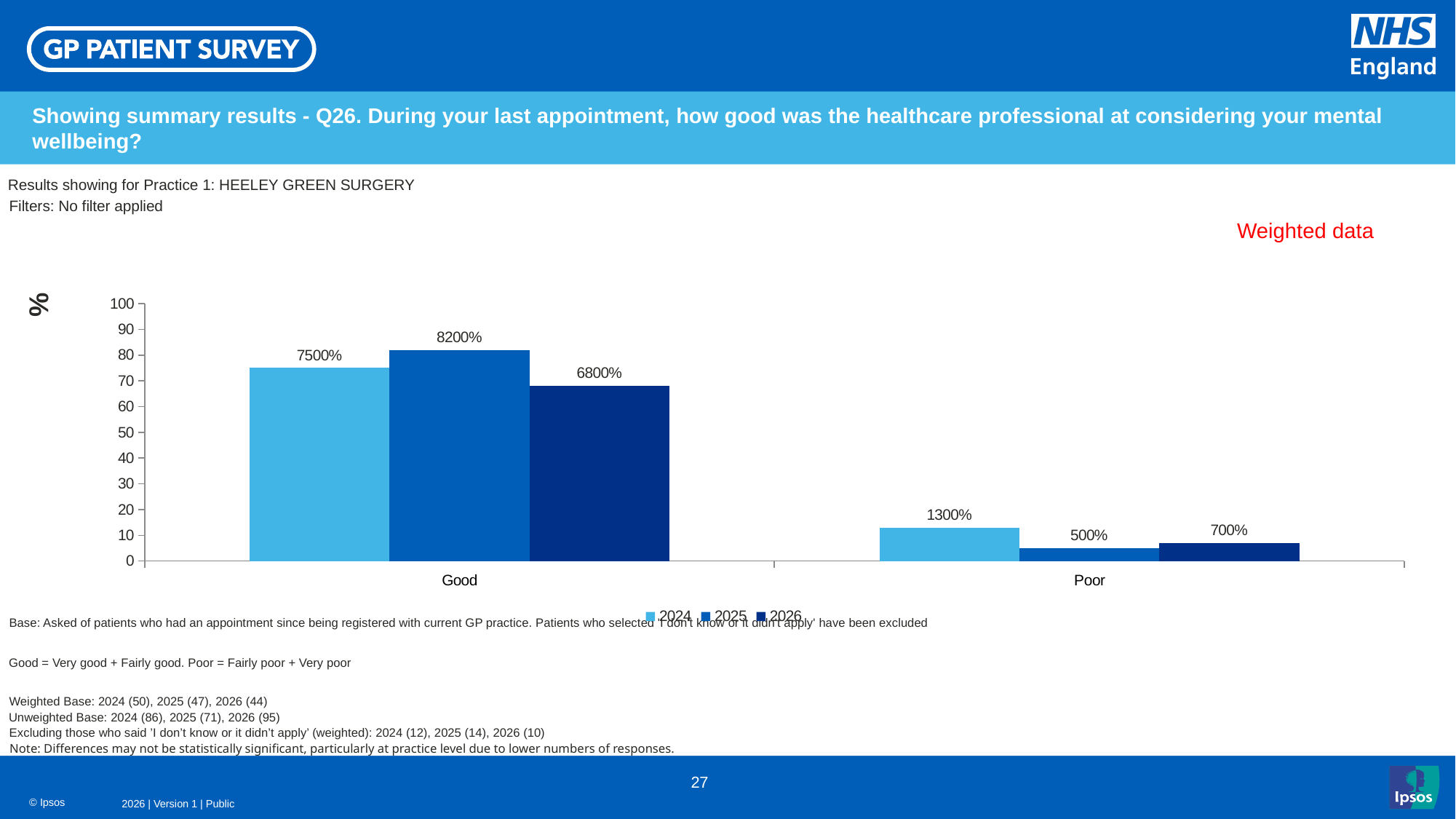
Which year has the highest bar in the Good category? 2025 How many categories are shown on the x axis? 2 How many series does the legend list? 3 Which year has the lowest bar in the Poor category? 2025 What kind of chart is shown on the slide? Bar chart What is the difference between the 2025 and 2024 data labels in the Good category? 700% What is the data label for 2024 in the Poor category? 1300% Which practice are the results shown for? HEELEY GREEN SURGERY What is the data label for 2026 in the Poor category? 700% What is the data label for 2025 in the Good category? 8200% What is the data label for 2024 in the Good category? 7500% Which is larger in the Good category, the 2024 bar or the 2026 bar? 2024